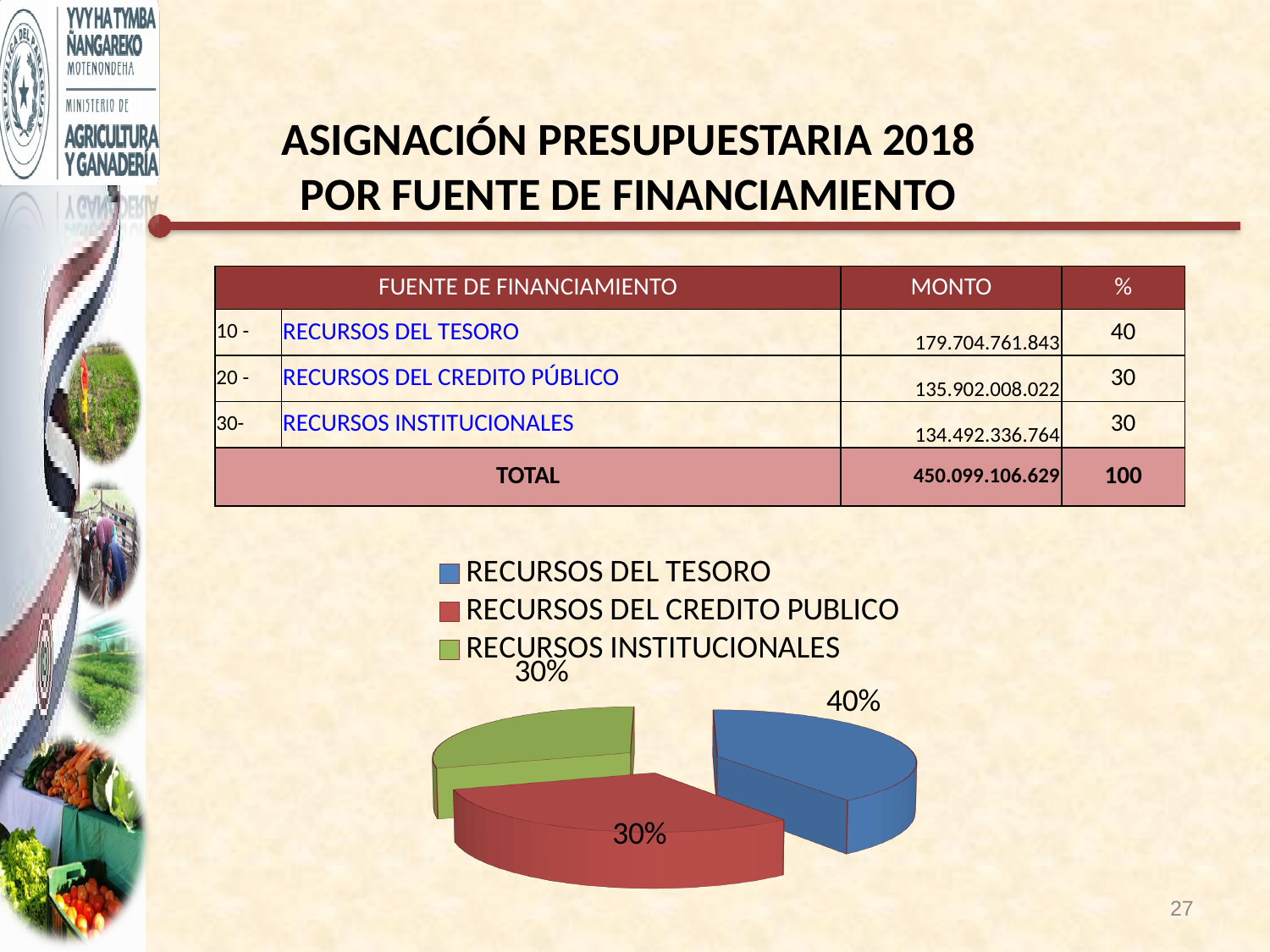
What kind of chart is shown on the slide? pie chart What colour is the RECURSOS INSTITUCIONALES slice in the pie chart? green What is the difference in percentage points between the RECURSOS DEL TESORO slice and the RECURSOS INSTITUCIONALES slice? 10 percentage points What colour is the RECURSOS DEL TESORO slice in the pie chart? blue What share of the pie does RECURSOS DEL CREDITO PUBLICO represent? 30% What share of the pie does RECURSOS INSTITUCIONALES represent? 30% Which is larger in the pie chart, RECURSOS DEL TESORO or RECURSOS DEL CREDITO PUBLICO? RECURSOS DEL TESORO Which slice of the pie chart is the largest? RECURSOS DEL TESORO What share of the pie does RECURSOS DEL TESORO represent? 40% How many slices does the pie chart have? 3 How many entries does the pie chart's legend list? 3